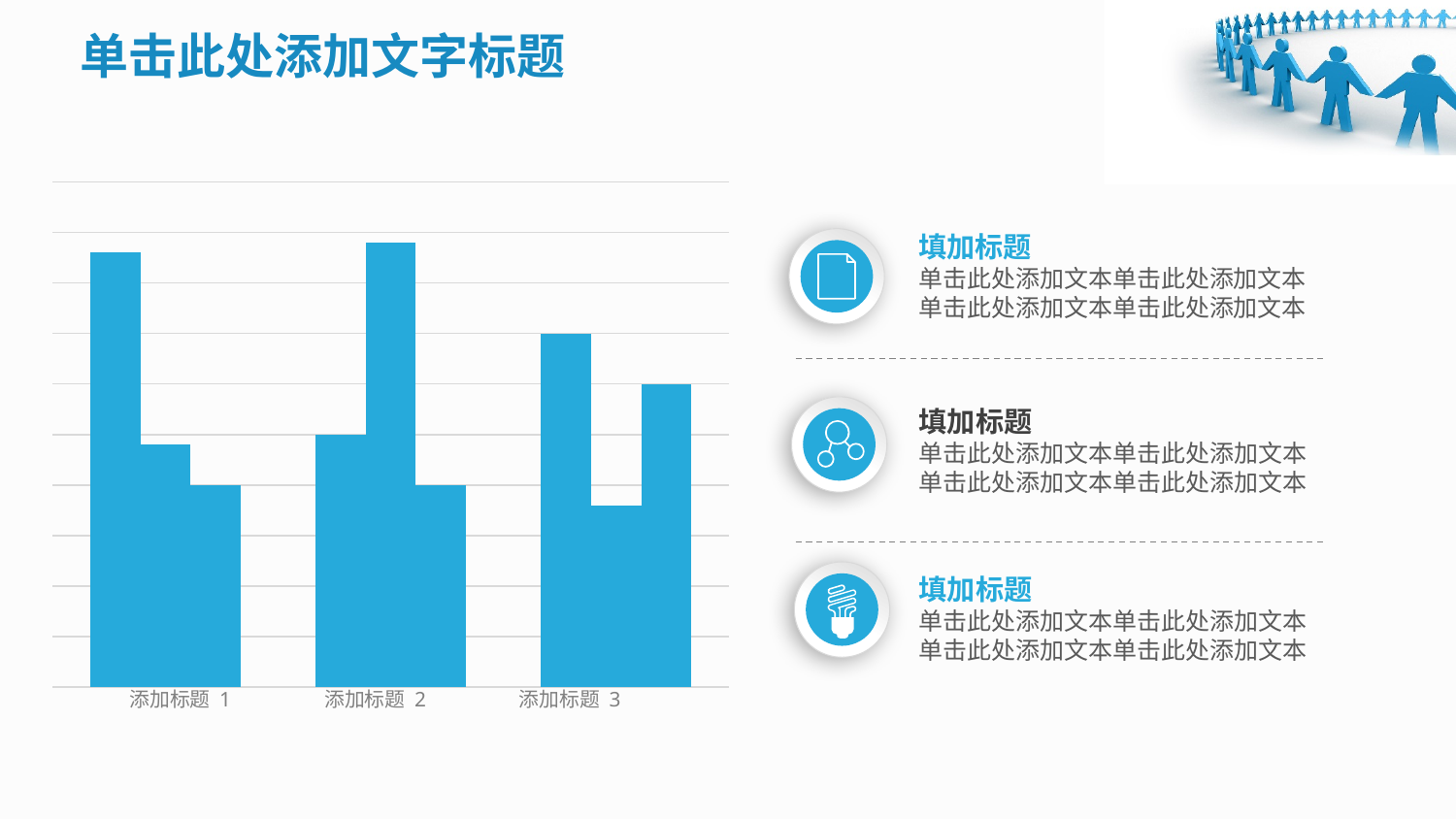
What is the label of the first category on the x axis of the bar chart? 添加标题 1 Is the first bar of 添加标题 1 taller or shorter than the first bar of 添加标题 3? taller Which category contains the tallest bar in the chart? 添加标题 2 Within 添加标题 1, which bar is the tallest: the first, second or third? the first What kind of chart is shown on the left of the slide? bar chart How many categories are shown on the x axis of the bar chart? 3 Does the bar chart display a legend? No Is the first bar of 添加标题 2 taller or shorter than the first bar of 添加标题 1? shorter Within 添加标题 3, is the third bar taller or shorter than the second bar? taller Which category contains the shortest bar in the chart? 添加标题 3 What is the label of the third category on the x axis of the bar chart? 添加标题 3 How many bars are plotted for each category in the bar chart? 3